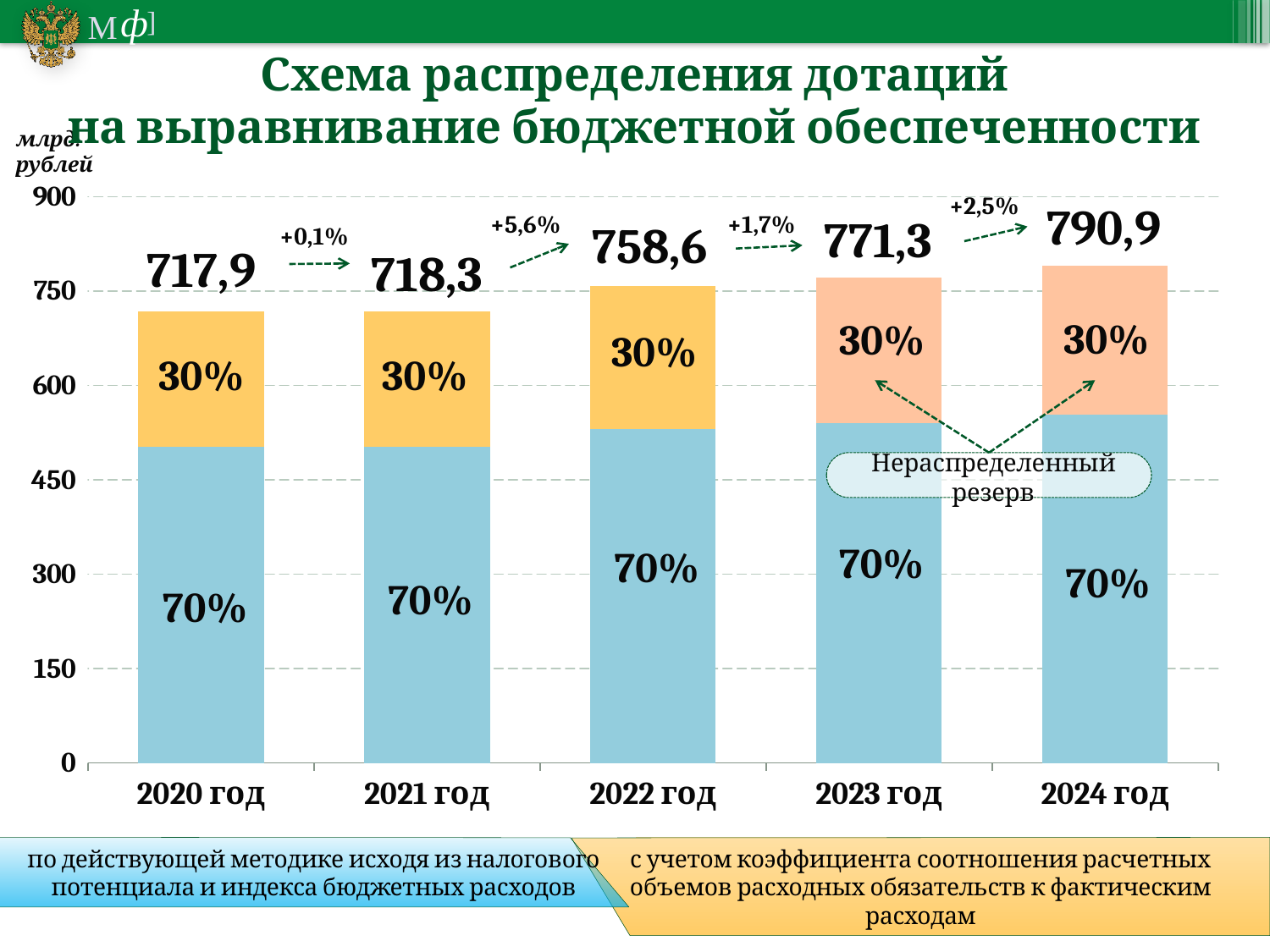
What kind of chart is shown on the slide? stacked bar chart Is the value of the bottom (70%) segment of the 2020 год bar greater or less than 600? less How many years are shown on the x axis? 5 Which year has the lowest total value? 2020 год What is the total value shown for 2020 год? 717,9 Do the total values rise or fall from 2020 год to 2024 год? rise Which is larger, the total for 2021 год or the total for 2023 год? 2023 год What is the total value shown for 2022 год? 758,6 Which year has the highest total value? 2024 год What is the difference between the total for 2024 год and the total for 2020 год? 73,0 What percentage share of each bar is the top segment? 30% What percentage growth is shown between 2021 год and 2022 год? +5,6%